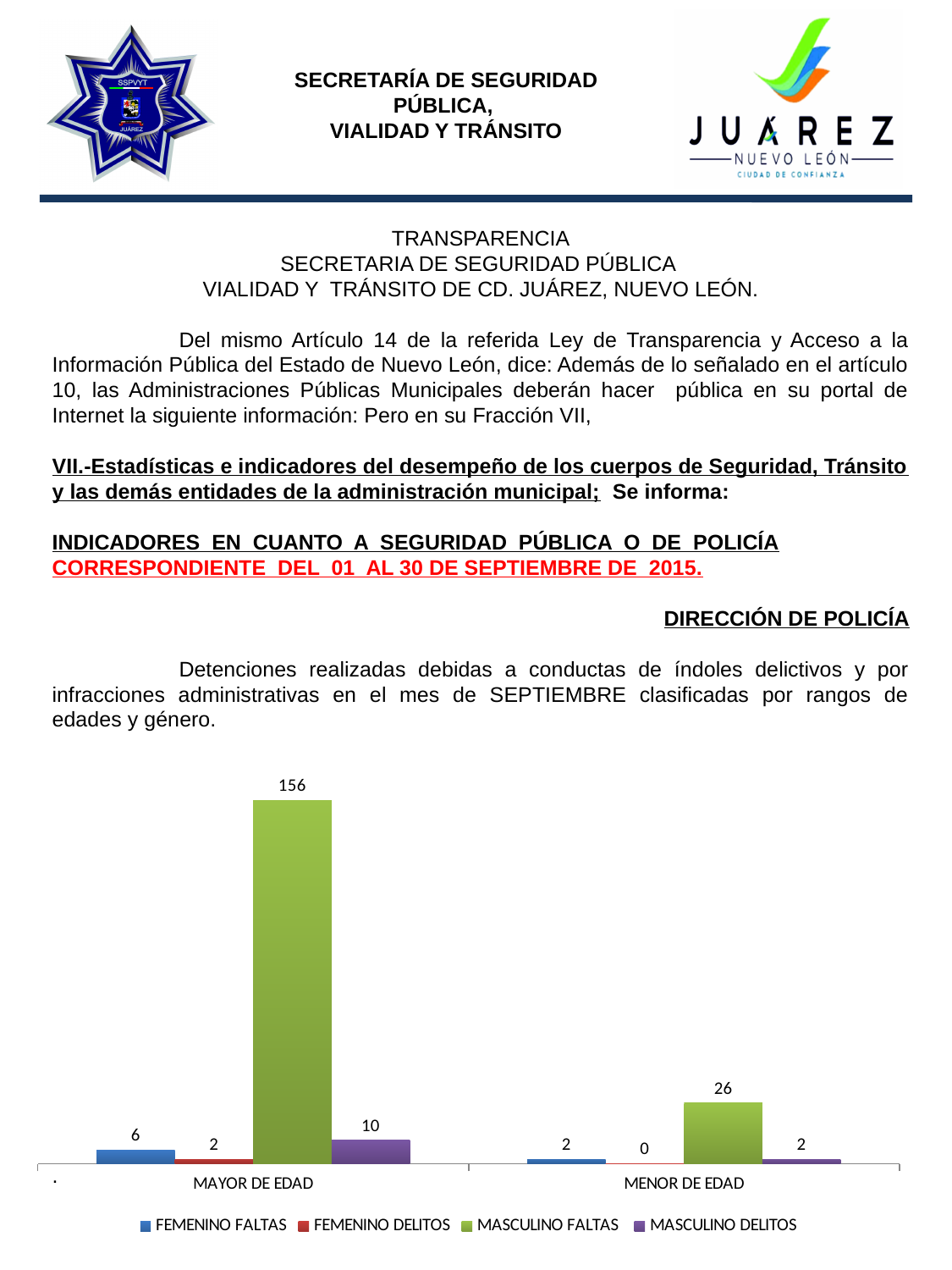
What is the value for MASCULINO DELITOS in the MAYOR DE EDAD category? 10 What is the value for FEMENINO FALTAS in the MENOR DE EDAD category? 2 What is the difference between MASCULINO FALTAS for MAYOR DE EDAD and MASCULINO FALTAS for MENOR DE EDAD? 130 What is the value for MASCULINO FALTAS in the MAYOR DE EDAD category? 156 Which series has the highest value in the MENOR DE EDAD category? MASCULINO FALTAS What is the value for FEMENINO DELITOS in the MENOR DE EDAD category? 0 What colour are the MASCULINO FALTAS bars in the chart? Green Which series has the lowest value in the MENOR DE EDAD category? FEMENINO DELITOS How many series does the legend list? 4 How many categories are shown on the x axis of the chart? 2 Which is larger: FEMENINO FALTAS for MAYOR DE EDAD or MASCULINO DELITOS for MAYOR DE EDAD? MASCULINO DELITOS for MAYOR DE EDAD What kind of chart is shown on the slide? Bar chart